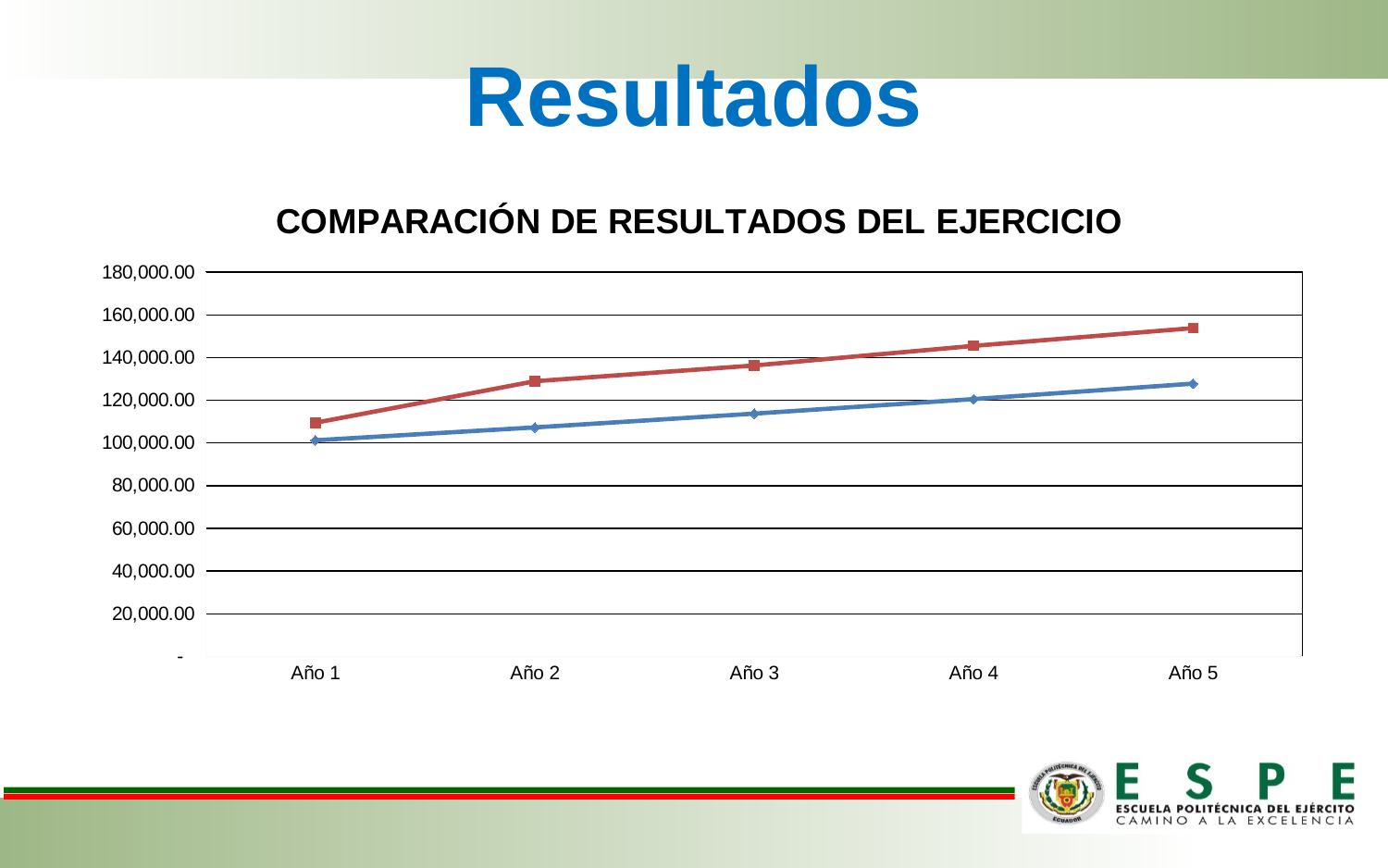
How many lines are plotted on the chart? 2 What is the title of the chart? COMPARACIÓN DE RESULTADOS DEL EJERCICIO How many categories are shown on the x axis? 5 Is the value of the red line at Año 2 greater or less than 140,000.00? less In which year does the red line reach its highest value? Año 5 Do the values of the blue line rise or fall from Año 1 to Año 5? rise In which year does the blue line have its lowest value? Año 1 Is the value of the blue line at Año 5 greater or less than 140,000.00? less Is the value of the red line at Año 5 greater or less than 140,000.00? greater Do the values of the red line rise or fall from Año 1 to Año 5? rise What kind of chart is shown on the slide? line chart At Año 3, which line has the larger value, the red line or the blue line? the red line